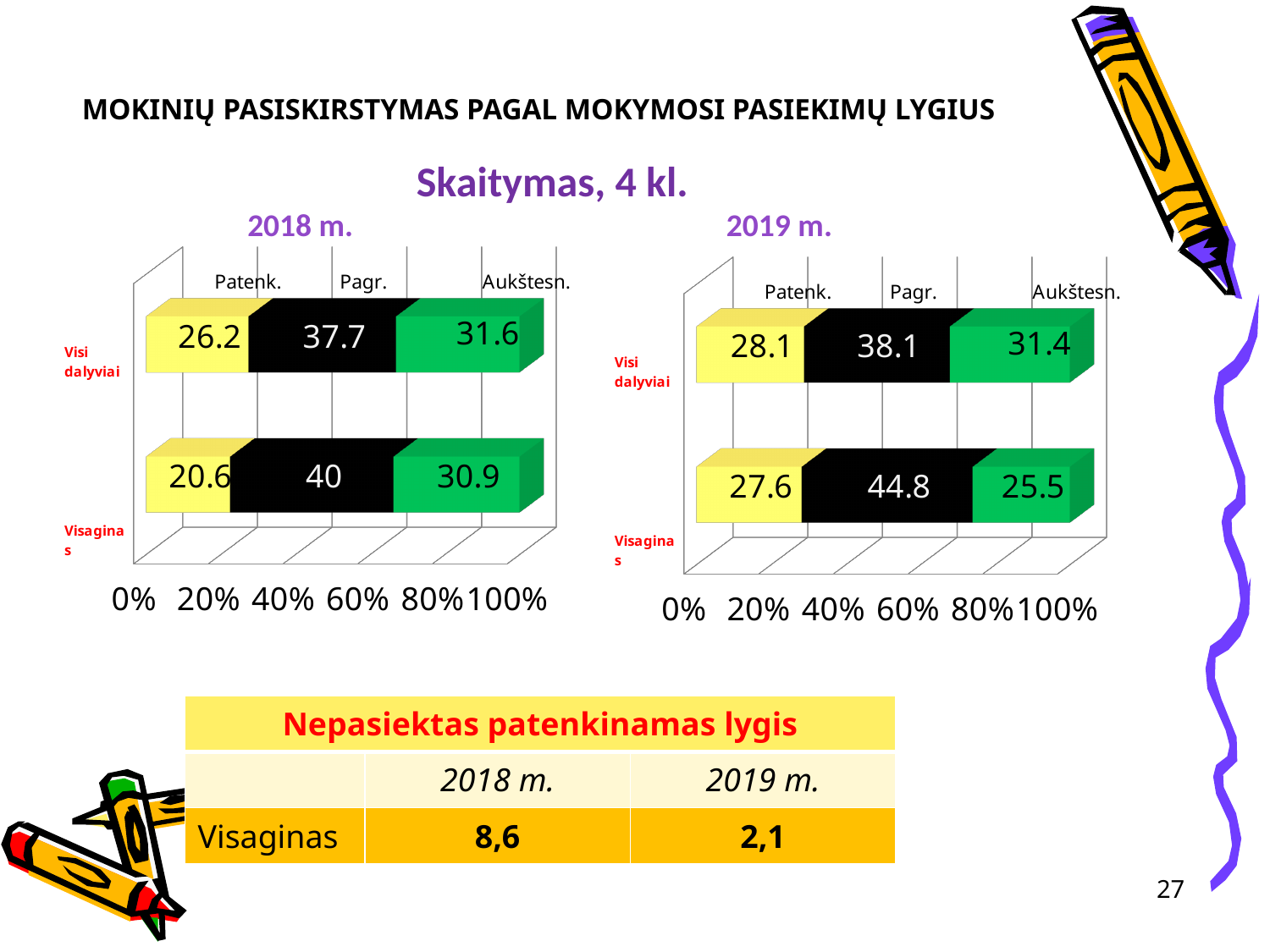
In the 2019 m. chart, what is the total of the stacked bar for Visaginas? 97.9 What kind of chart is the 2018 m. chart? Stacked bar chart In the 2018 m. chart, what is the difference between the Patenk. values for Visi dalyviai and Visaginas? 5.6 In the 2019 m. chart, which series has the highest value for Visi dalyviai? Pagr. In the 2018 m. chart, which series has the lowest value for Visaginas? Patenk. In the 2019 m. chart, what is the Aukštesn. value for Visaginas? 25.5 How many categories are shown in the 2019 m. chart? 2 In the 2018 m. chart, what is the Aukštesn. value for Visi dalyviai? 31.6 In the 2018 m. chart, what is the Pagr. value for Visaginas? 40 In the 2019 m. chart, what is the Patenk. value for Visi dalyviai? 28.1 In the 2019 m. chart, which is larger for Visaginas: the Pagr. value or the Aukštesn. value? Pagr.